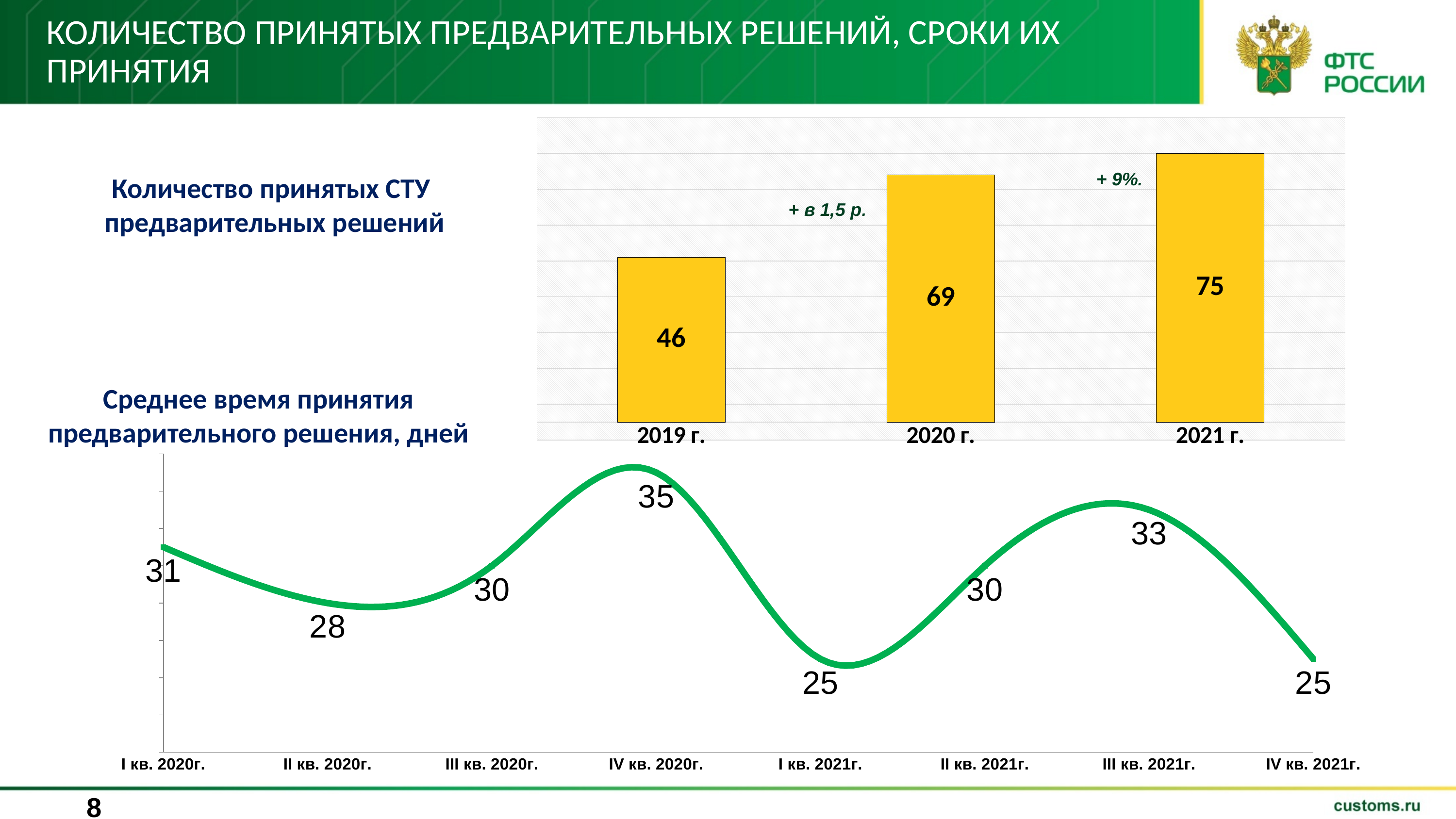
In the line chart 'Среднее время принятия предварительного решения, дней', how many quarters are plotted? 8 In the line chart 'Среднее время принятия предварительного решения, дней', which is larger: the value for III кв. 2021г. or the value for I кв. 2021г.? III кв. 2021г. In the bar chart 'Количество принятых СТУ предварительных решений', do the values rise or fall from 2019 г. to 2021 г.? rise In the line chart 'Среднее время принятия предварительного решения, дней', which quarter has the highest value? IV кв. 2020г. In the bar chart 'Количество принятых СТУ предварительных решений', what is the difference between the values for 2021 г. and 2019 г.? 29 In the bar chart 'Количество принятых СТУ предварительных решений', what is the value for 2020 г.? 69 In the line chart 'Среднее время принятия предварительного решения, дней', what is the value for IV кв. 2020г.? 35 In the bar chart 'Количество принятых СТУ предварительных решений', which year has the lowest value? 2019 г. In the bar chart 'Количество принятых СТУ предварительных решений', which year has the highest value? 2021 г. In the line chart 'Среднее время принятия предварительного решения, дней', what is the value for II кв. 2020г.? 28 In the bar chart 'Количество принятых СТУ предварительных решений', how many years are shown? 3 What type of chart is the top-right chart 'Количество принятых СТУ предварительных решений'? bar chart